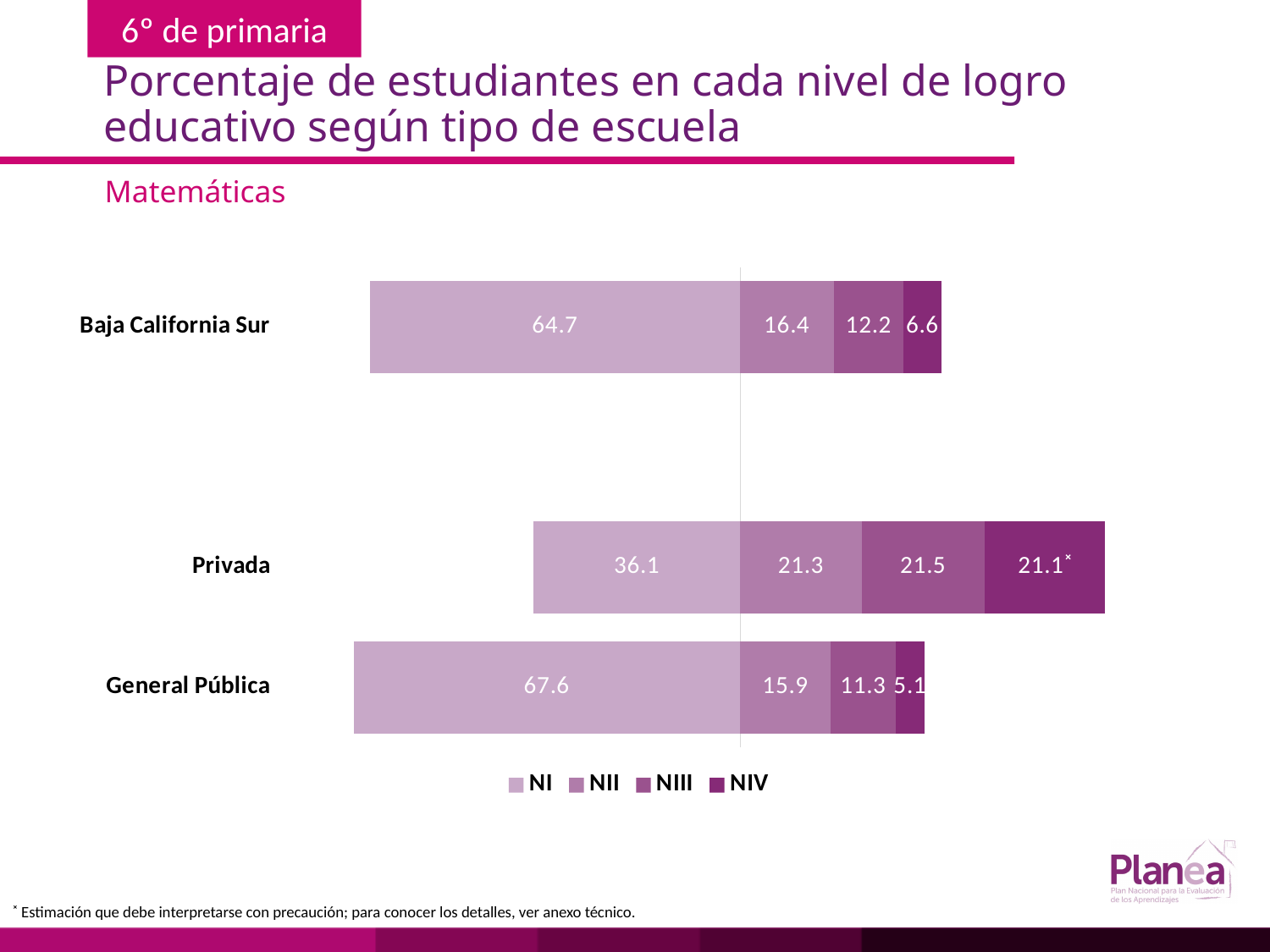
What kind of chart is shown on the slide? Stacked bar chart Which category has the lowest NIV value? General Pública Which school type has the highest NI value? General Pública What is the NIV value for General Pública? 5.1 Which is larger, the NIV value for Privada or the NIV value for Baja California Sur? Privada How many series does the legend list? 4 What is the difference between the NI values for General Pública and Privada? 31.5 What is the NI value for Baja California Sur? 64.7 What is the NII value for General Pública? 15.9 What is the NIII value for Privada? 21.5 How many categories are shown on the chart? 3 What is the total of the stacked bar for Privada? 100.0